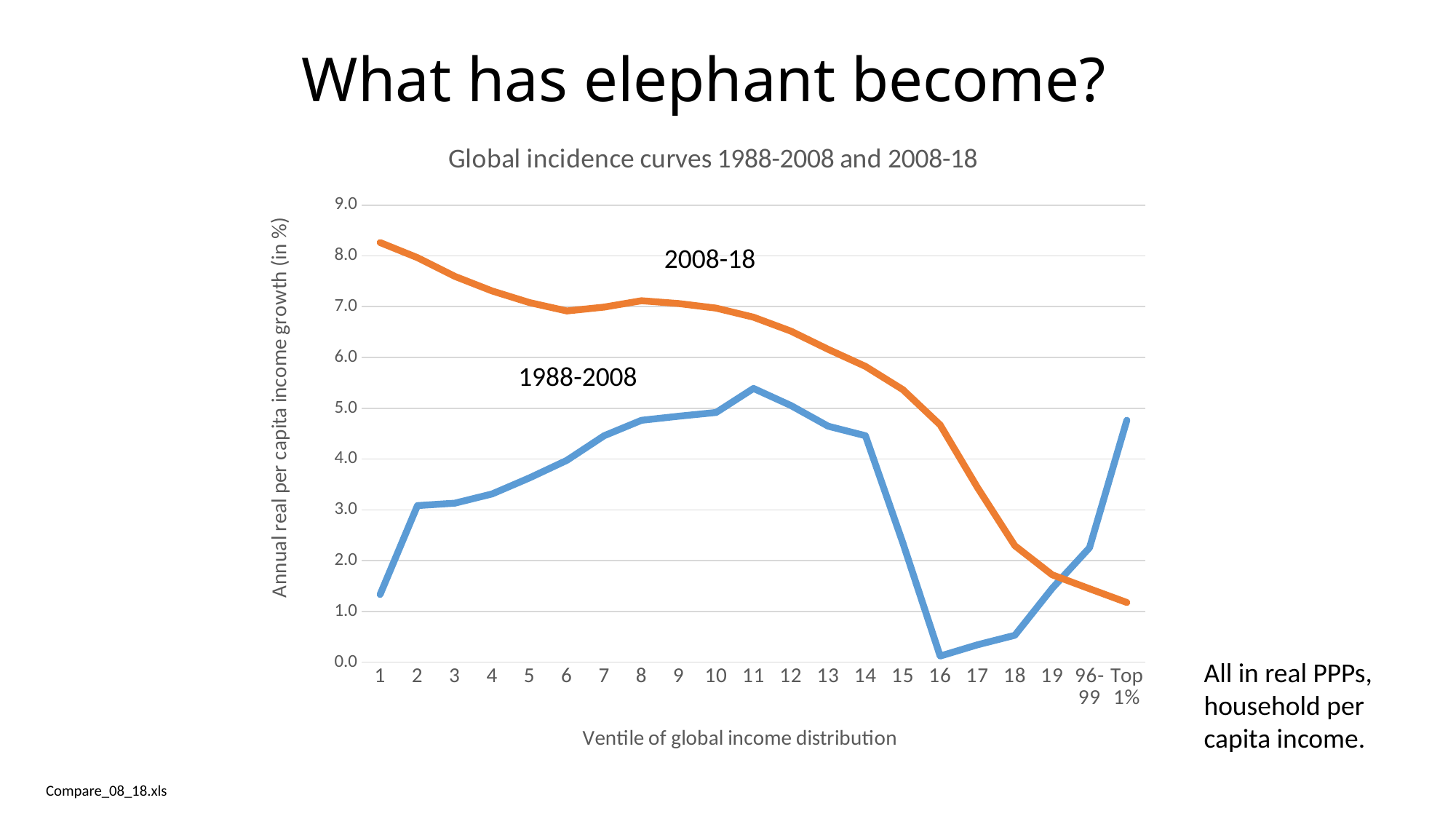
How many series are plotted on the chart? 2 Is the value for the 2008-18 series at Top 1% greater or less than 2.0? less Is the value for the 1988-2008 series at ventile 16 greater or less than 1.0? less At which ventile does the 1988-2008 series reach its lowest value? 16 Is the value for the 2008-18 series at ventile 1 greater or less than 8.0? greater At which ventile does the 2008-18 series reach its highest value? 1 How many categories are shown on the x axis of the chart? 21 What kind of chart is shown on the slide? line chart What is the title of the chart? Global incidence curves 1988-2008 and 2008-18 What is the label of the y axis? Annual real per capita income growth (in %) At ventile 5, which series has the higher value, 1988-2008 or 2008-18? 2008-18